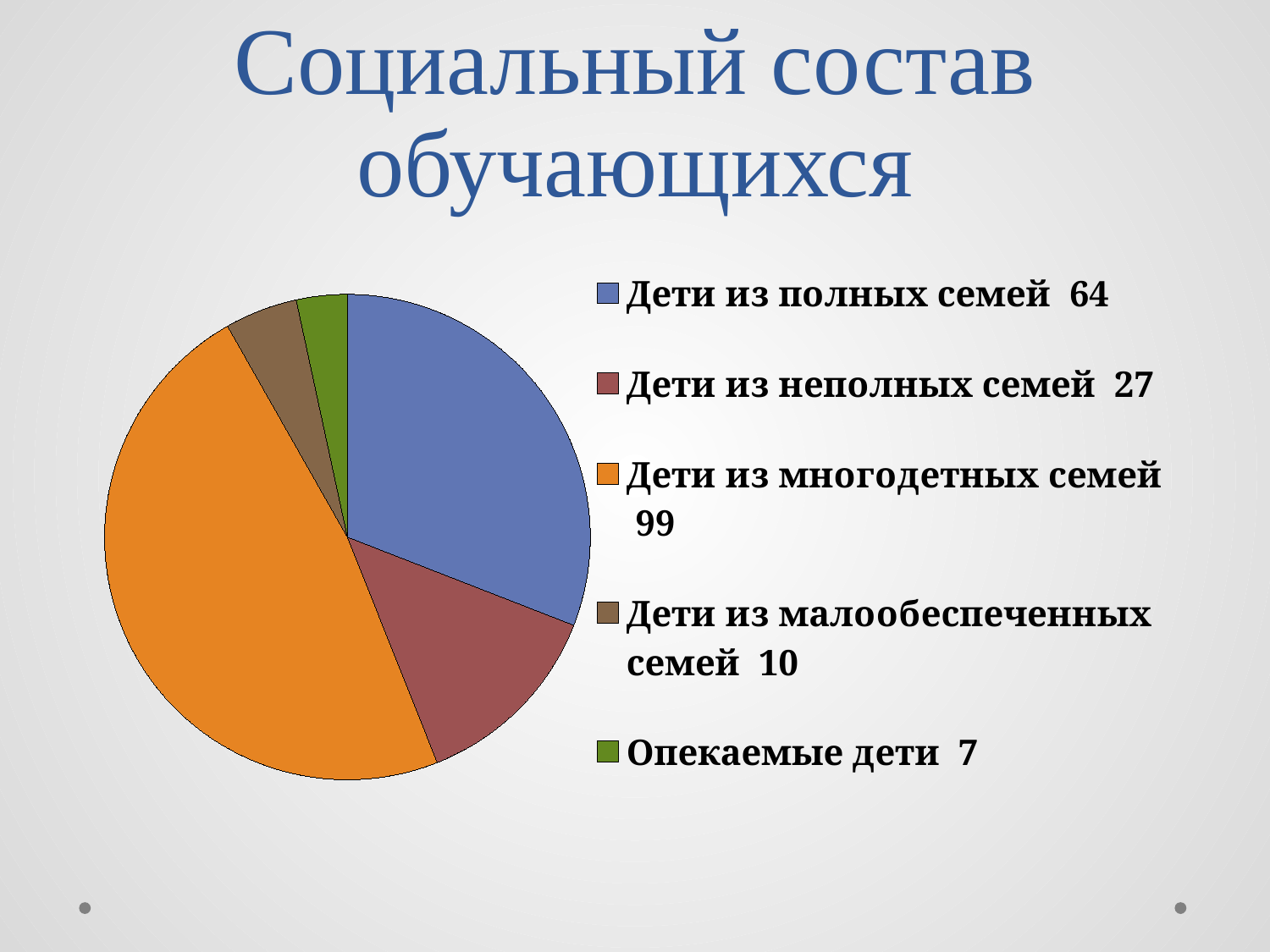
What is the title of the slide containing the chart? Социальный состав обучающихся What is the difference between the values for Дети из неполных семей and Дети из малообеспеченных семей? 17 What is the value for Дети из полных семей? 64 What is the value for Опекаемые дети? 7 Which category has the smallest slice of the pie? Опекаемые дети Which is larger: the value for Дети из полных семей or the value for Дети из неполных семей? Дети из полных семей How many categories does the pie chart have? 5 What kind of chart is shown on the slide? Pie chart What is the difference between the values for Дети из многодетных семей and Дети из полных семей? 35 Which category has the largest slice of the pie? Дети из многодетных семей What is the value for Дети из многодетных семей? 99 What is the value for Дети из малообеспеченных семей? 10